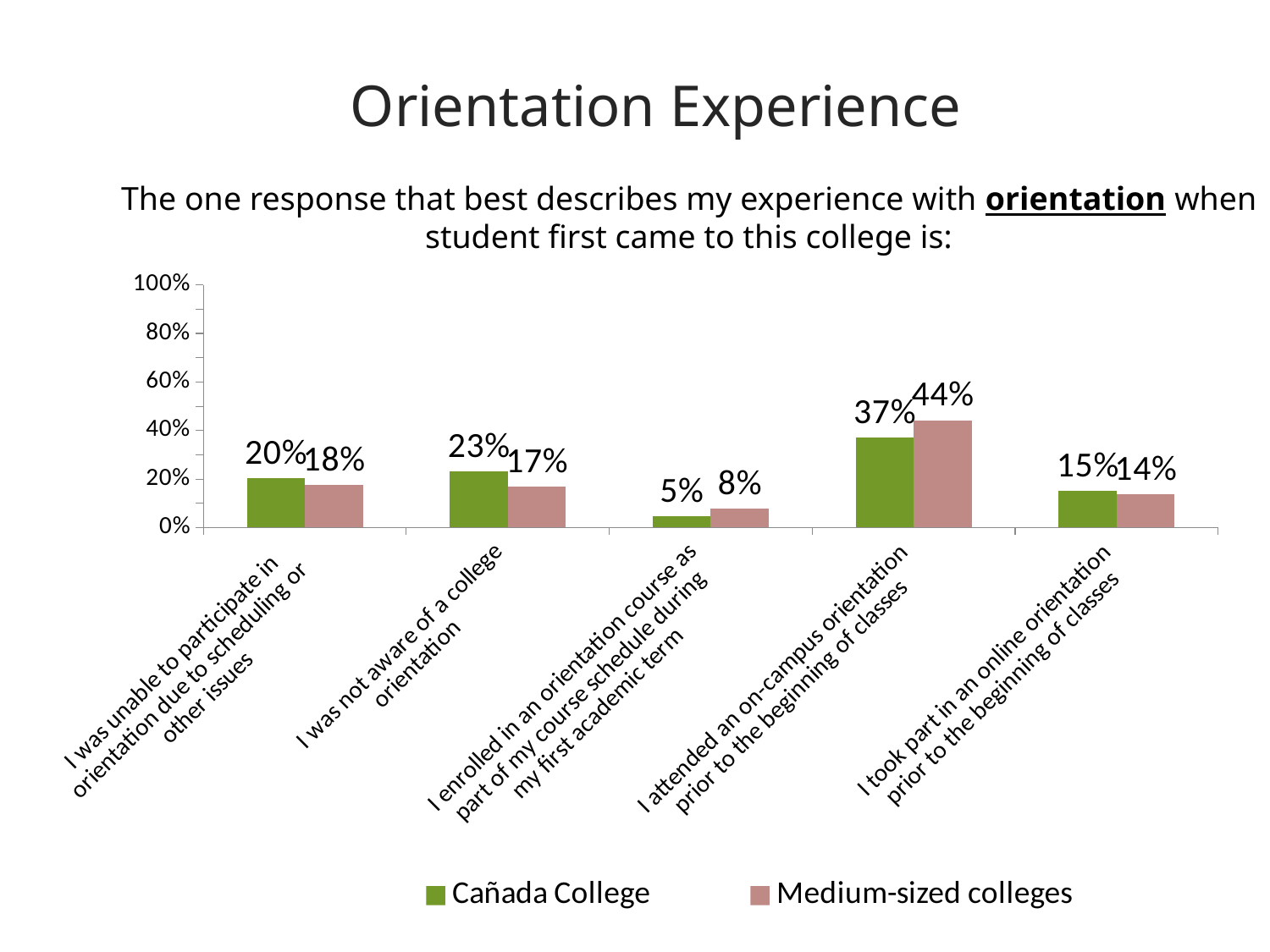
What is the Cañada College value for 'I enrolled in an orientation course as part of my course schedule during my first academic term'? 5% What is the Cañada College value for 'I took part in an online orientation prior to the beginning of classes'? 15% What is the difference between the Medium-sized colleges and Cañada College values for 'I attended an on-campus orientation prior to the beginning of classes'? 7% How many response categories are shown on the x axis? 5 For 'I was not aware of a college orientation', which series has the larger value, Cañada College or Medium-sized colleges? Cañada College How many series does the legend list? 2 Which response category has the highest value for Medium-sized colleges? I attended an on-campus orientation prior to the beginning of classes What is the Medium-sized colleges value for 'I was not aware of a college orientation'? 17% Is the Medium-sized colleges value for 'I attended an on-campus orientation prior to the beginning of classes' greater or less than 40%? greater Which response category has the lowest value for Cañada College? I enrolled in an orientation course as part of my course schedule during my first academic term What kind of chart is shown on the slide? Bar chart What percentage of Cañada College students said they attended an on-campus orientation prior to the beginning of classes? 37%